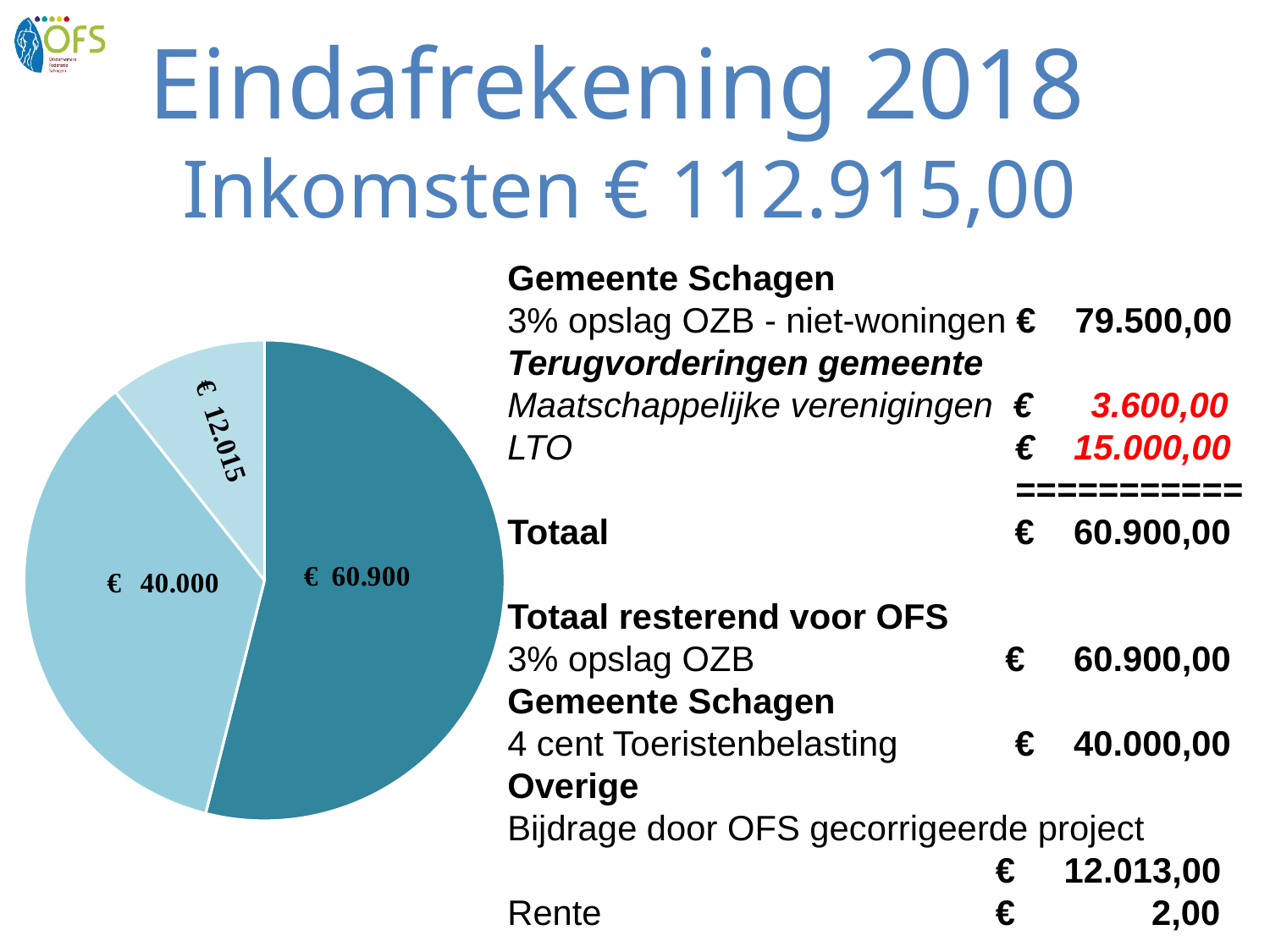
Which is larger in the pie chart: the slice labelled € 40.000 or the slice labelled € 12.015? € 40.000 Is the € 60.900 slice more or less than half of the pie chart? more What is the difference between the € 40.000 slice and the € 12.015 slice in the pie chart? € 27.985 What is the value of the largest slice of the pie chart? € 60.900 Does the pie chart have a legend? No What is the value of the smallest slice of the pie chart? € 12.015 What kind of chart is shown on the slide? pie chart What is the difference between the € 60.900 slice and the € 40.000 slice in the pie chart? € 20.900 How many slices does the pie chart have? 3 What value is shown on the dark teal slice of the pie chart? € 60.900 What is the total of all three slices in the pie chart? € 112.915 What value is shown on the lightest blue slice of the pie chart? € 12.015